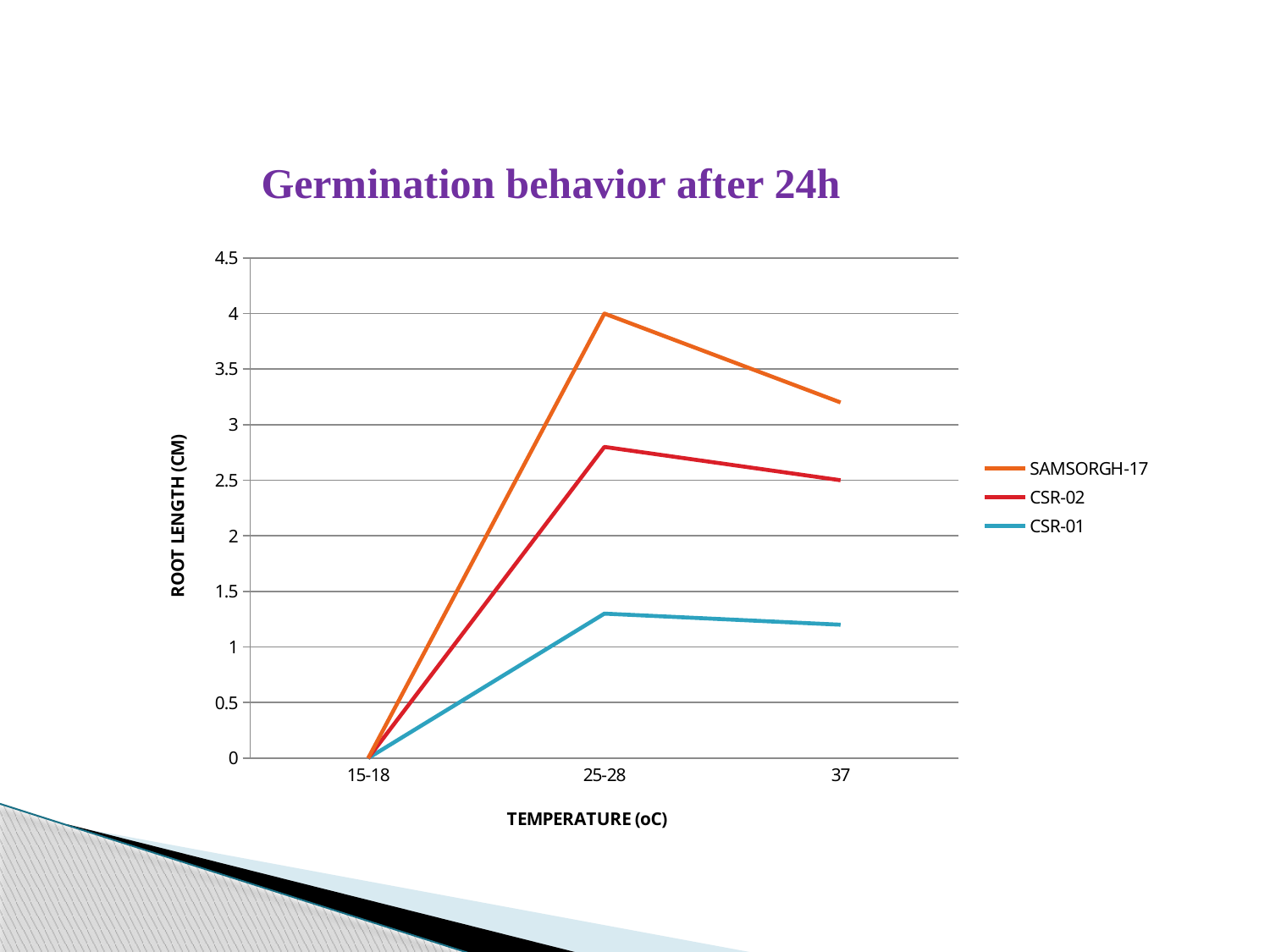
What is the root length for CSR-02 at 37 °C? 2.5 Which series has the lowest root length at 37 °C? CSR-01 How many temperature categories are shown on the x axis? 3 How many series does the legend list? 3 Is the root length for SAMSORGH-17 at 37 °C greater or less than 3.5? less Which series has the highest root length at 25-28 °C? SAMSORGH-17 Is the root length for CSR-02 at 25-28 °C greater or less than 2.5? greater Which is larger at 37 °C, the root length for CSR-02 or for CSR-01? CSR-02 What kind of chart is shown on the slide? line chart What is the label of the y axis? ROOT LENGTH (CM) What is the root length for CSR-01 at 15-18 °C? 0 What is the root length for SAMSORGH-17 at 25-28 °C? 4